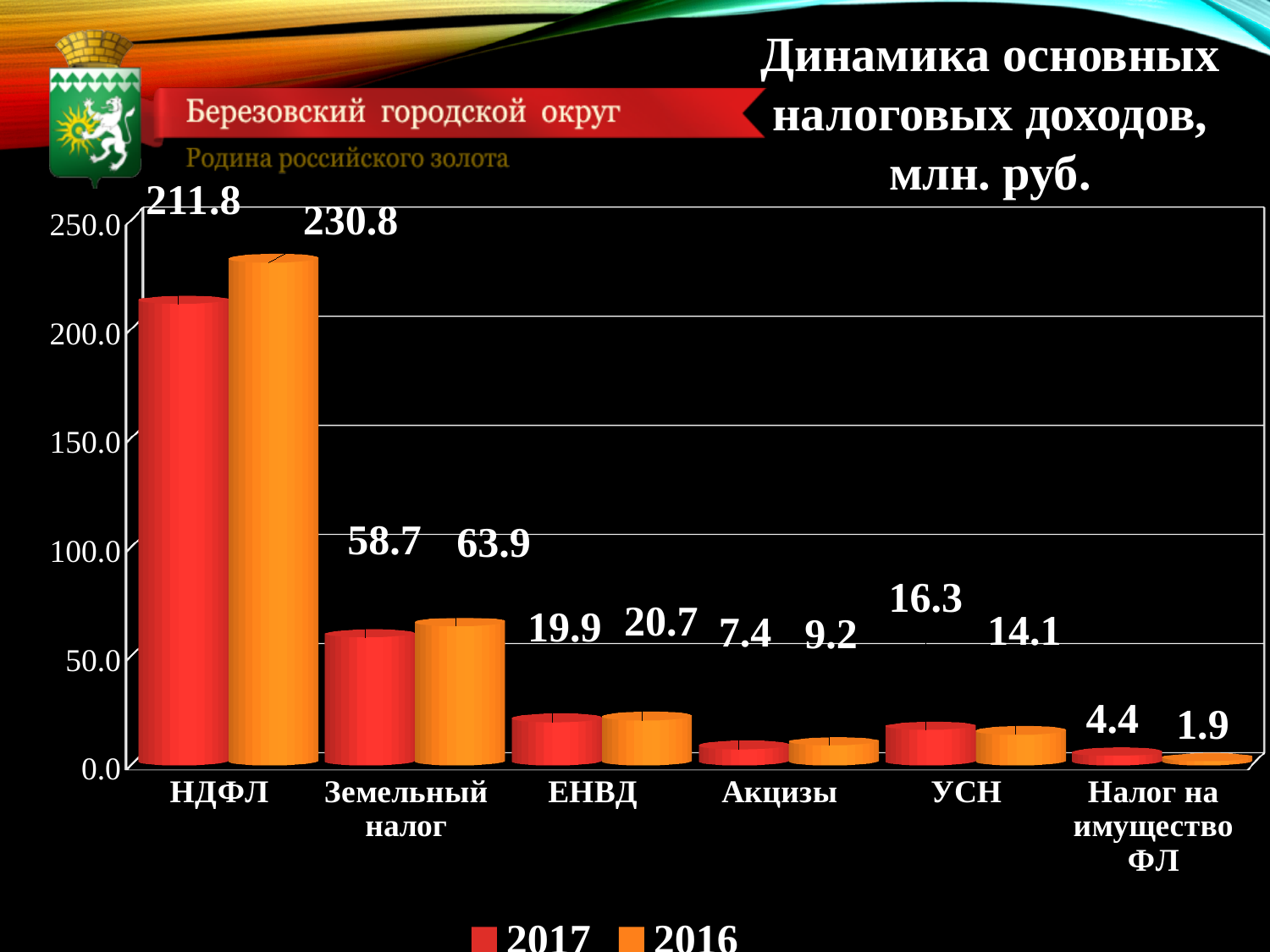
What is the difference between the 2016 and 2017 values for НДФЛ? 19.0 What is the 2017 value for НДФЛ? 211.8 What kind of chart is shown on the slide? bar chart How many series does the legend list? 2 Which colour represents the 2016 series? orange Which category has the lowest 2017 value? Налог на имущество ФЛ What is the 2016 value for Налог на имущество ФЛ? 1.9 Which category has the highest 2016 value? НДФЛ What is the 2016 value for Земельный налог? 63.9 What is the 2017 value for УСН? 16.3 Which is larger for УСН, the 2017 value or the 2016 value? 2017 How many categories are shown on the x axis? 6